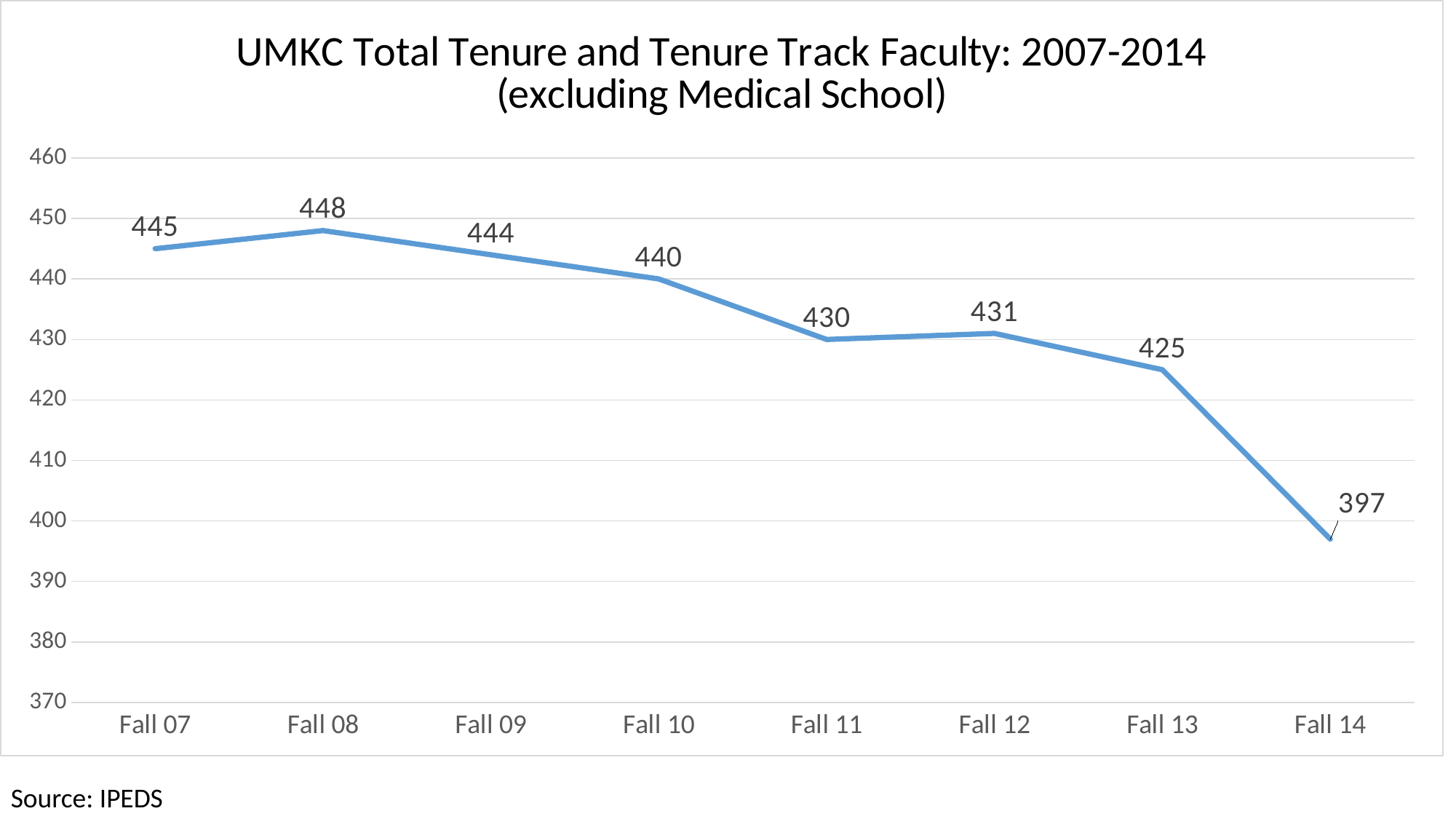
What is the difference between the values for Fall 08 and Fall 10? 8 Do the values generally rise or fall from Fall 08 to Fall 14? Fall How many data points are plotted on the chart? 8 Which period has the lowest value? Fall 14 What is the value for Fall 07? 445 Is the value for Fall 13 greater or less than 420? greater Which period has the highest value? Fall 08 What is the value for Fall 11? 430 What is the value for Fall 14? 397 What is the difference between the values for Fall 13 and Fall 14? 28 Which is larger, the value for Fall 09 or the value for Fall 12? Fall 09 What kind of chart is shown on the slide? Line chart